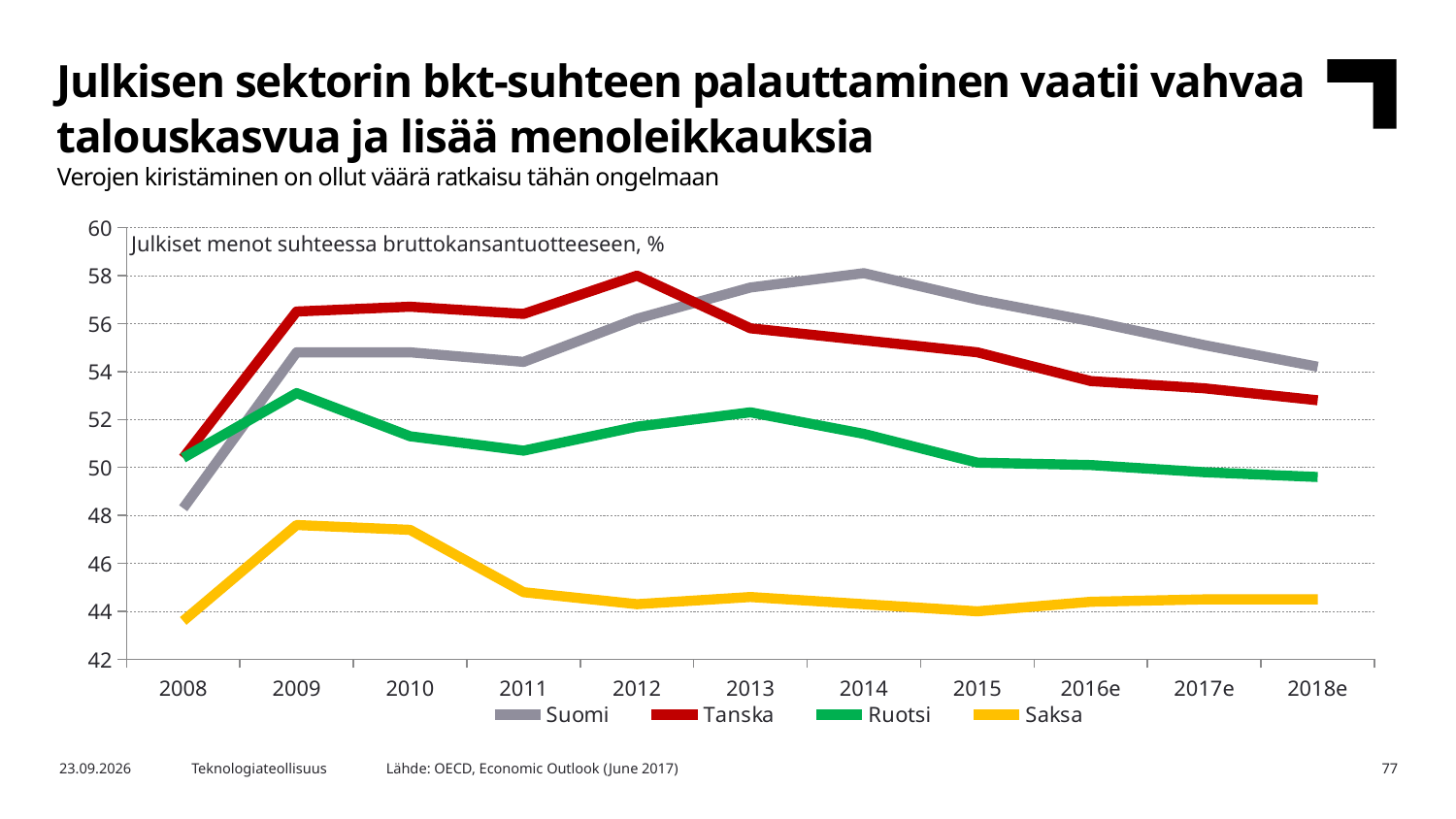
Is the value for Saksa in 2008 greater or less than 46? less Which is larger in 2009, the value for Tanska or the value for Suomi? Tanska Which series has the highest value in 2014? Suomi How many years are shown on the x axis? 11 In which year does Tanska reach its highest value? 2012 Which series has the lowest value in 2008? Saksa Does the value for Suomi rise or fall from 2014 to 2018e? fall Is the value for Tanska in 2012 greater or less than 56? greater Which is larger in 2018e, the value for Suomi or the value for Tanska? Suomi What kind of chart is shown on the slide? line chart Is the value for Suomi in 2014 greater or less than 56? greater How many series does the legend list? 4